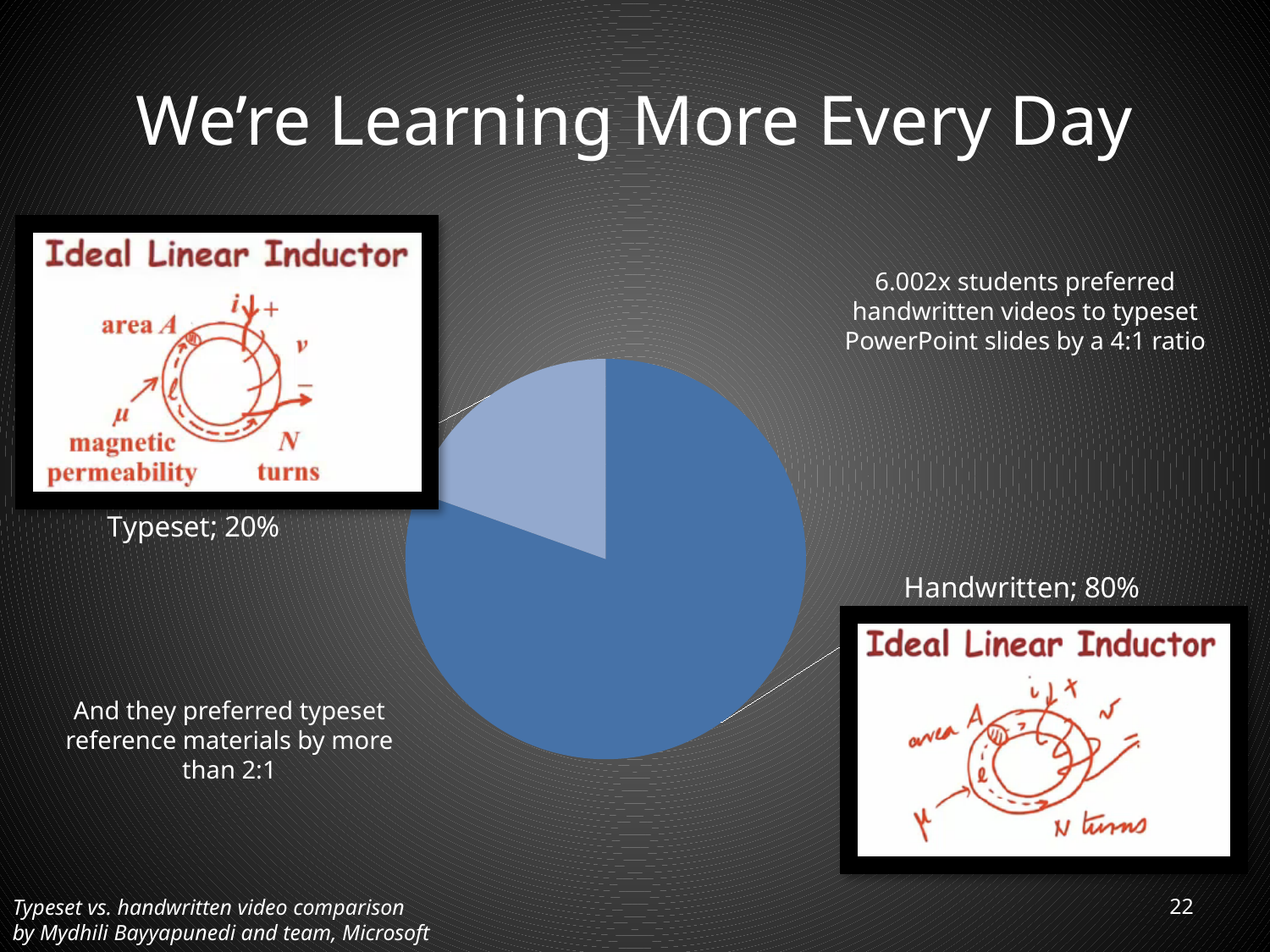
Which is larger, the Handwritten slice or the Typeset slice? Handwritten Which slice of the pie is the smallest? Typeset What is the difference in percentage points between the Handwritten and Typeset slices? 60 What is the title of the slide containing the pie chart? We're Learning More Every Day What share of the pie does the Handwritten slice represent? 80% What share of the pie does the Typeset slice represent? 20% Which slice of the pie is the largest? Handwritten What kind of chart is shown on the slide? pie chart How many slices does the pie chart have? 2 Which slice of the pie is drawn in the lighter blue colour? Typeset Is the Typeset share greater or less than 50%? less